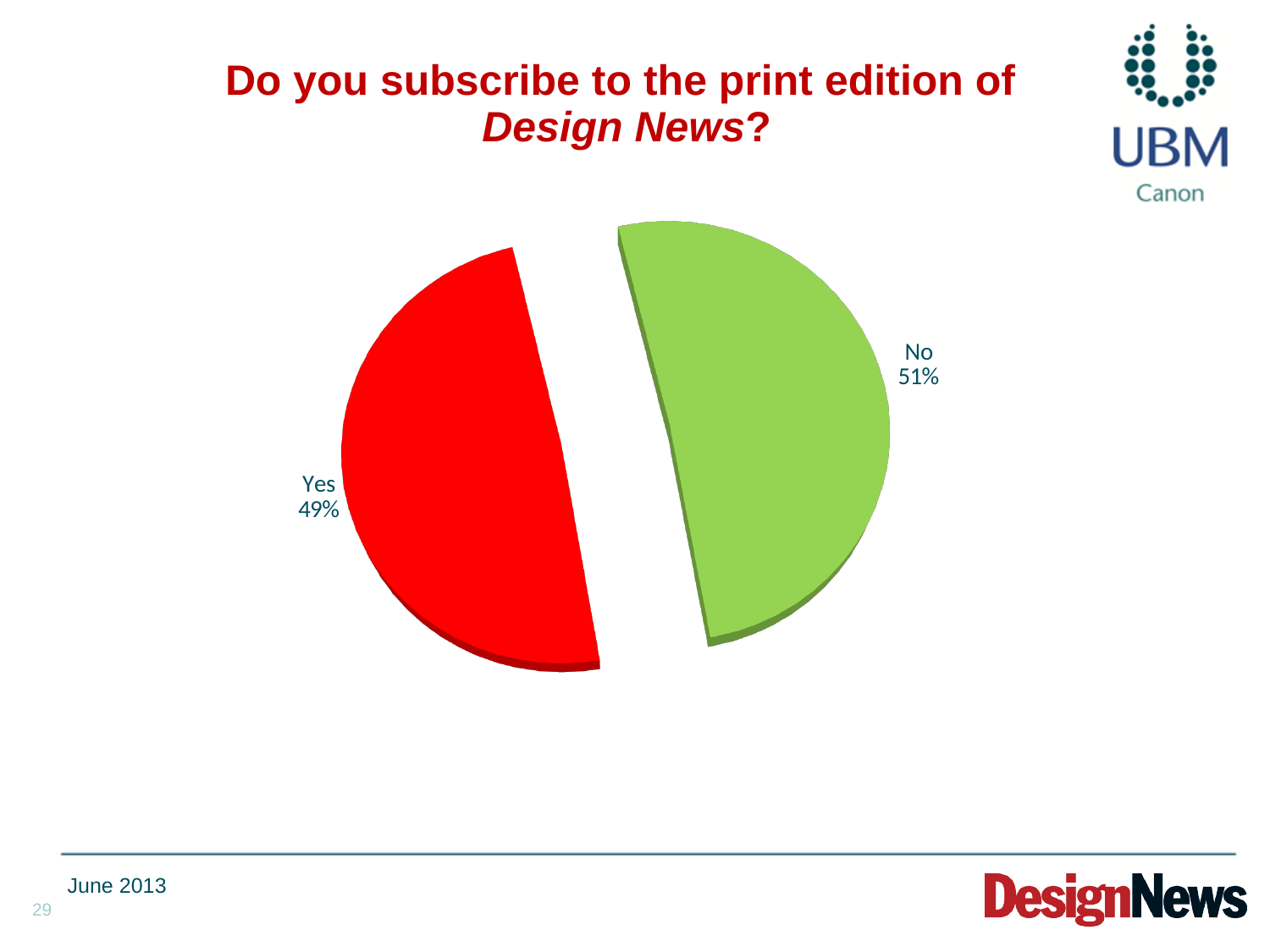
Is the share for "Yes" larger or smaller than the share for "No"? smaller What share of the pie does the "No" slice represent? 51% What question does the chart title ask? Do you subscribe to the print edition of Design News? What colour is the "Yes" slice? red What percentage of respondents answered "Yes" to subscribing to the print edition of Design News? 49% How many slices does the pie chart have? 2 Which response has the larger share of the pie? No What percentage of respondents answered "No"? 51% Which response has the smaller share of the pie? Yes What is the difference in percentage points between the "No" and "Yes" slices? 2 percentage points What type of chart is shown on the slide? pie chart Is the value for "No" greater or less than 50%? greater